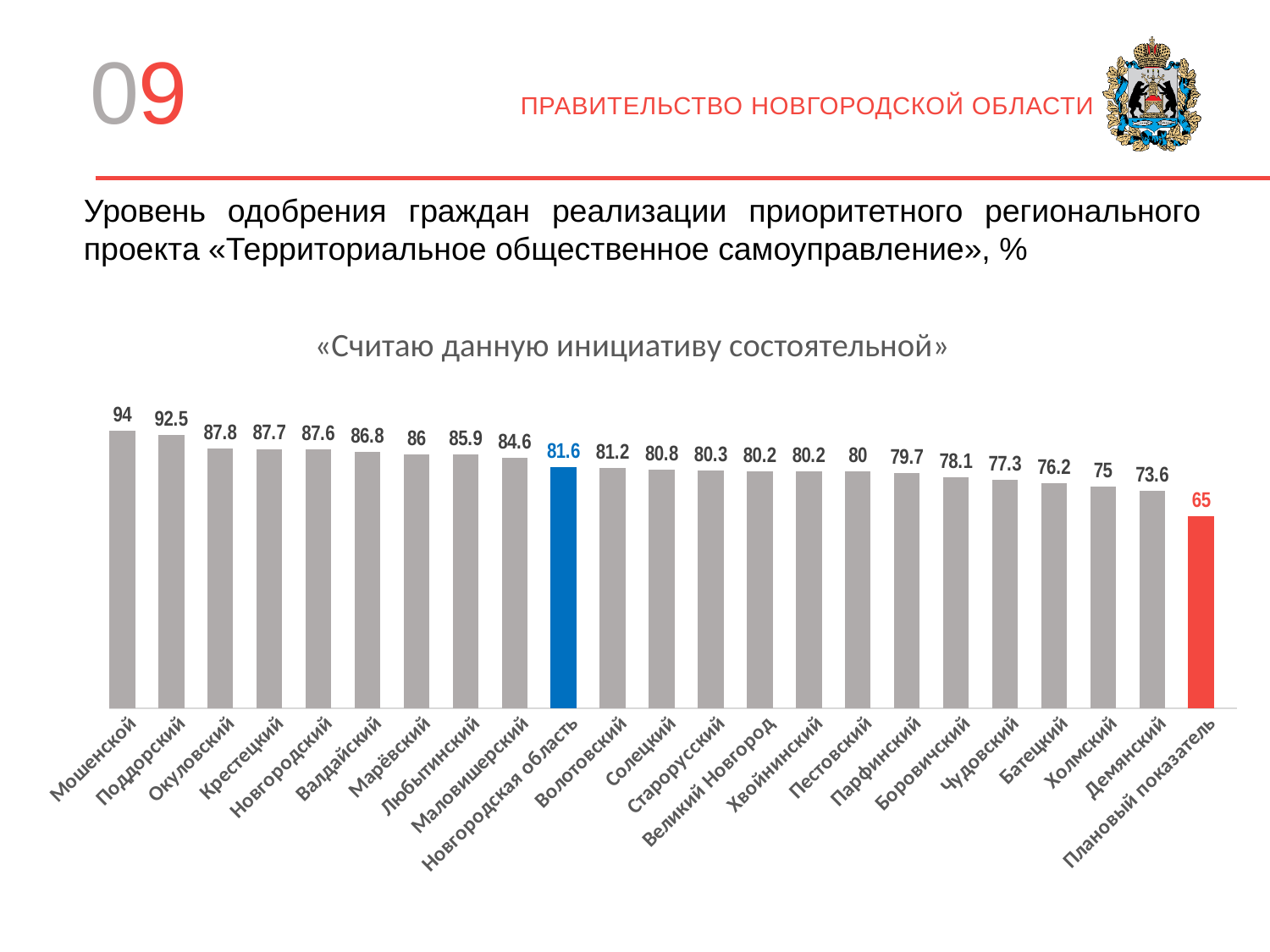
Which category has the highest value? Мошенской What is the value for Новгородская область? 81.6 What is the difference between the values for Новгородская область and Демянский? 8 How many bars are shown in the chart? 23 What is the value for Плановый показатель? 65 Which category has the lowest value? Плановый показатель What kind of chart is shown on the slide? Bar chart What is the title of the chart? «Считаю данную инициативу состоятельной» What is the difference between the values for Мошенской and Плановый показатель? 29 What is the value for Мошенской? 94 Which is larger, the value for Поддорский or the value for Холмский? Поддорский What is the value for Великий Новгород? 80.2